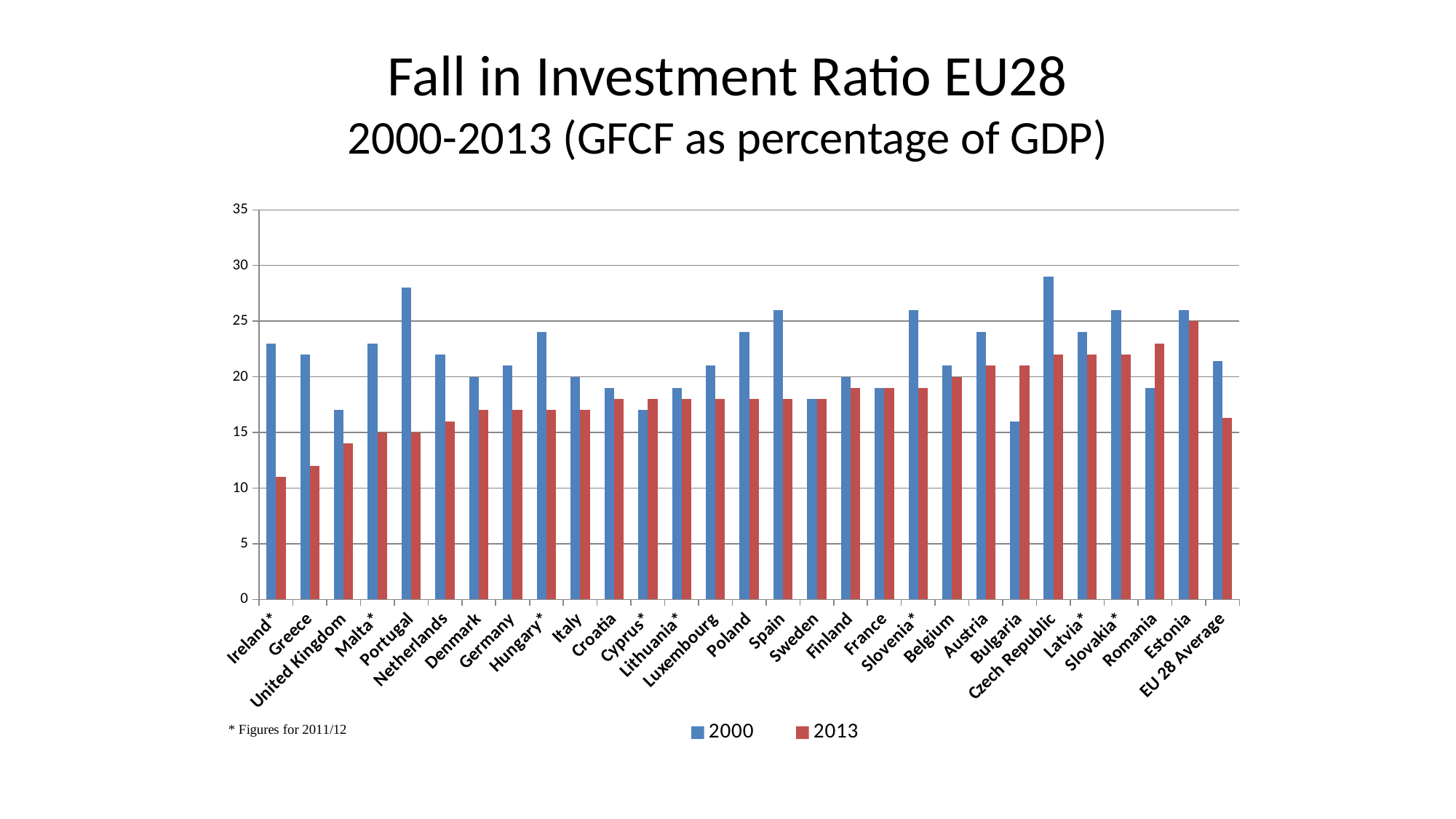
What does the asterisk footnote below the chart say? * Figures for 2011/12 Is the 2000 value for Portugal greater or less than 25? greater For Romania, which series has the larger value, 2000 or 2013? 2013 Which category has the highest value for the 2000 series? Czech Republic Which category has the highest value for the 2013 series? Estonia How many categories are shown along the x axis? 29 For Bulgaria, which series has the larger value, 2000 or 2013? 2013 Which category has the lowest value for the 2013 series? Ireland* How many series does the legend list? 2 Is the 2013 value for Ireland* greater or less than 15? less Is the 2013 value for Greece greater or less than 15? less What kind of chart is shown on the slide? Bar chart